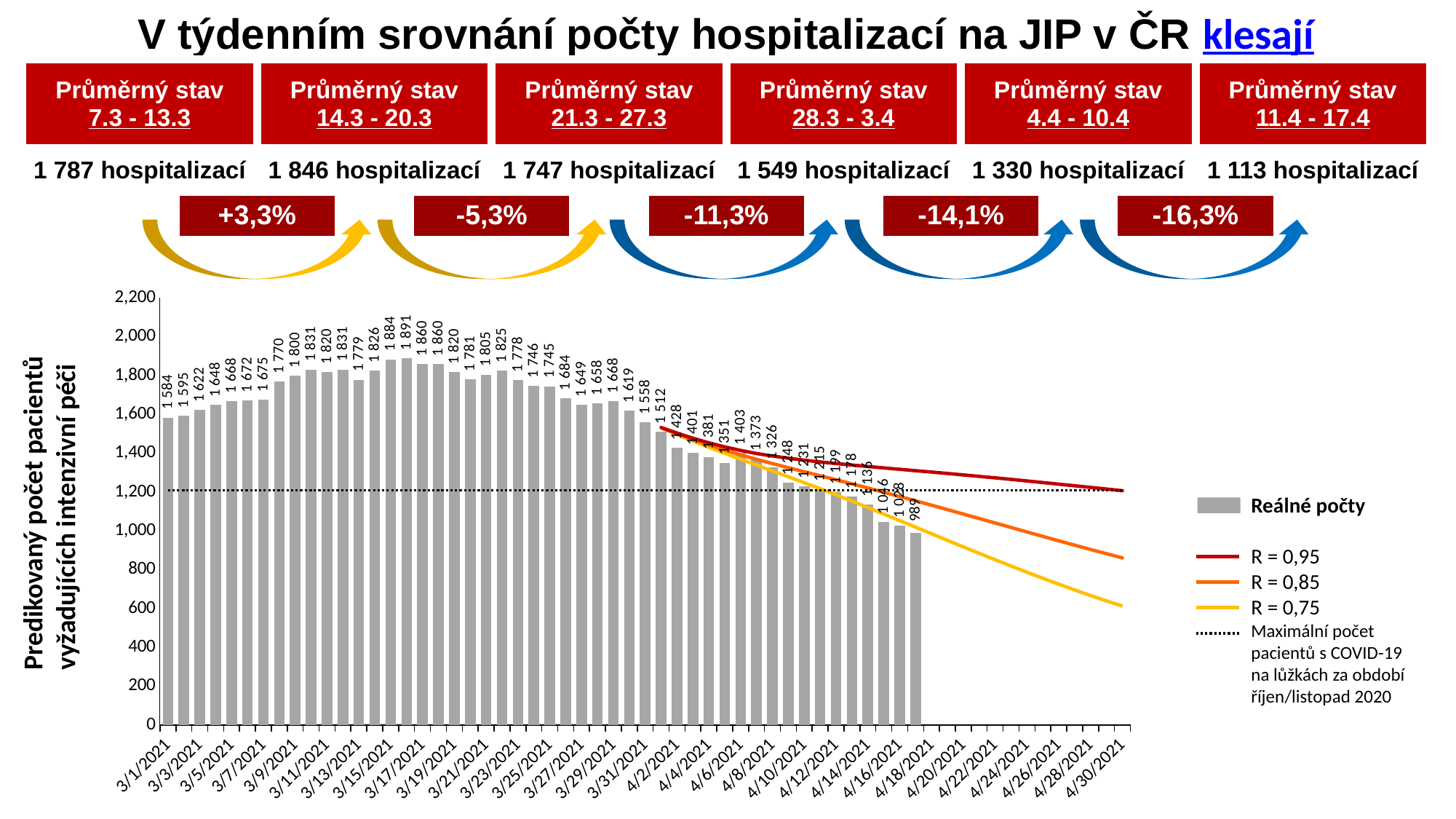
What is the value of the bar for 3/1/2021? 1 584 What kind of chart is shown on the slide? combination bar and line chart What is the difference between the highest bar value (1 891) and the value for 3/1/2021 (1 584)? 307 What is the lowest value among the grey bars (Reálné počty)? 989 Is the value of the R = 0,75 line at 4/30/2021 greater or less than 800? less At 4/30/2021, which prediction line is higher: R = 0,95 or R = 0,75? R = 0,95 How many entries does the legend list? 5 Do the grey bars rise or fall from 4/1/2021 to the last bar? fall What colour is the R = 0,75 line? yellow What is the title of the vertical axis? Predikovaný počet pacientů vyžadujících intenzivní péči What is the highest value among the grey bars (Reálné počty)? 1 891